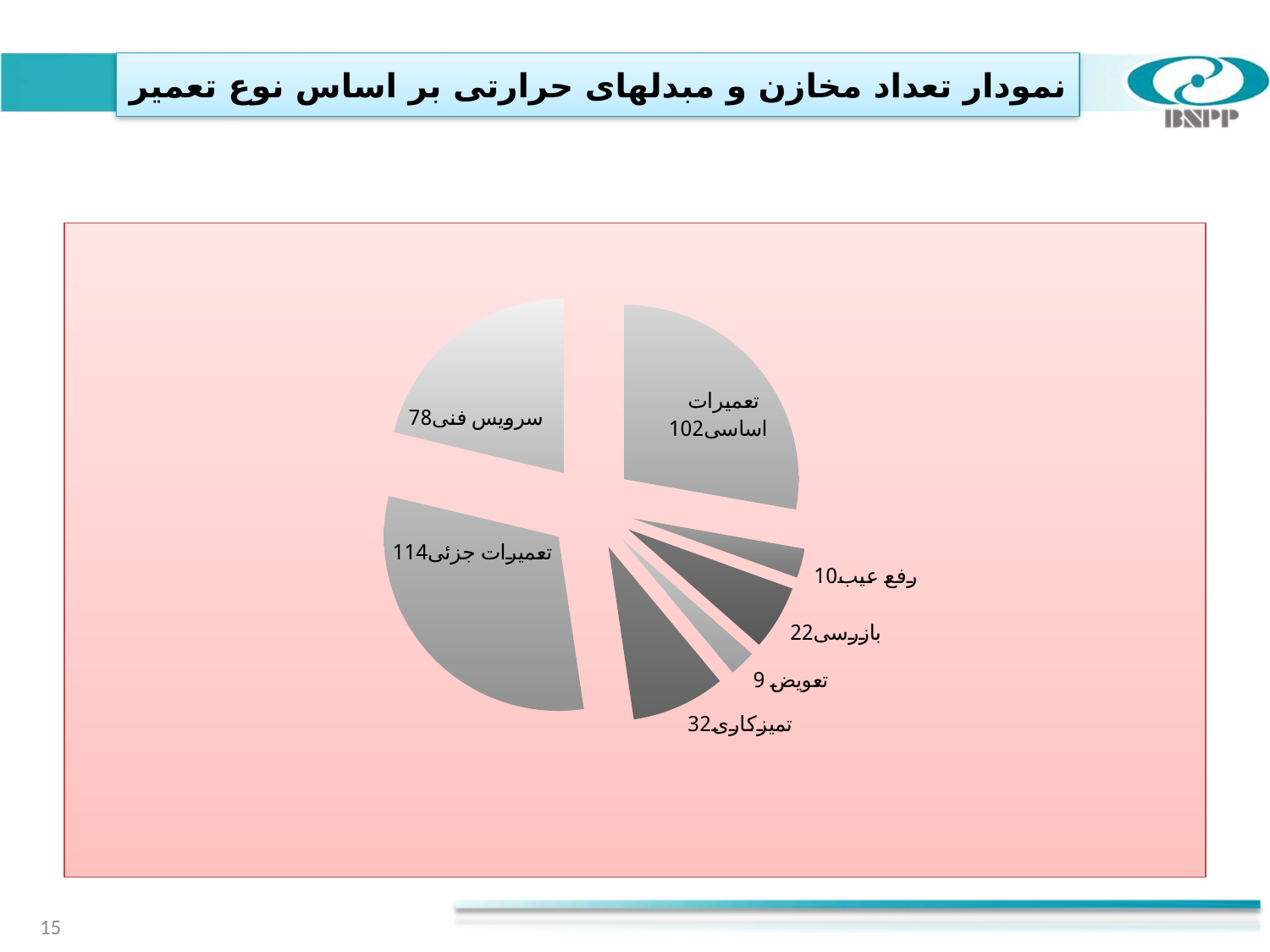
What is the value for تمیزکاری? 32 What is the value for سرویس فنی? 78 Which category has the highest value? تعمیرات جزئی Which is larger, رفع عیب or بازرسی? بازرسی What is the value for تعمیرات اساسی? 102 What is the difference between تعمیرات جزئی and تعمیرات اساسی? 12 Which category has the lowest value? تعویض What is the title of the slide? نمودار تعداد مخازن و مبدلهای حرارتی بر اساس نوع تعمیر What is the total of all slices in the pie chart? 367 What is the value for بازرسی? 22 What type of chart is shown on the slide? Pie chart How many slices does the pie chart have? 7